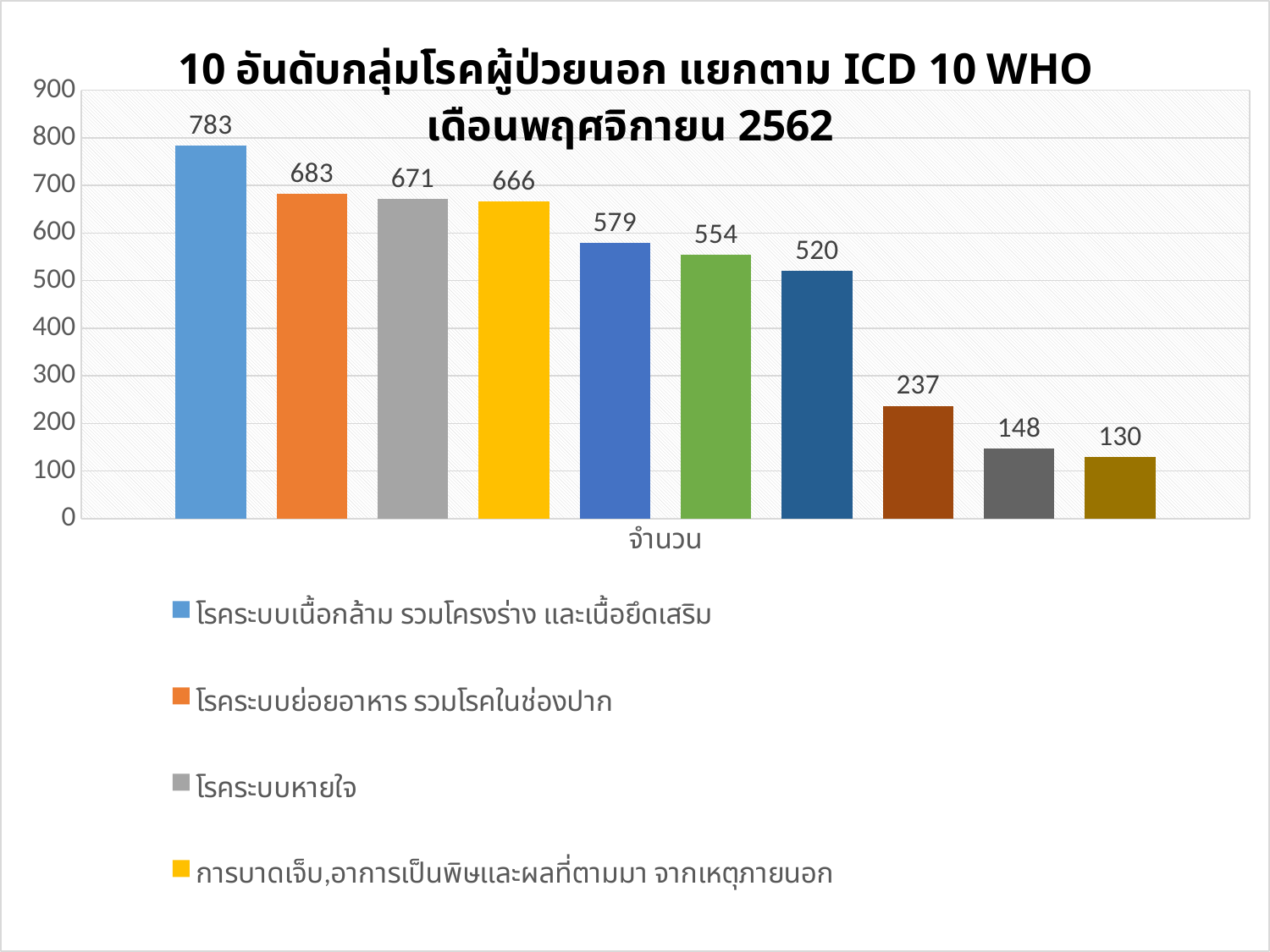
What is the label shown under the x axis of the chart? จำนวน What is the lowest value shown on the chart? 130 How many bars are plotted on the chart? 10 What is the difference between the values for โรคระบบหายใจ and การบาดเจ็บ,อาการเป็นพิษและผลที่ตามมา จากเหตุภายนอก? 5 What is the value for โรคระบบหายใจ? 671 What is the value for การบาดเจ็บ,อาการเป็นพิษและผลที่ตามมา จากเหตุภายนอก? 666 What kind of chart is shown on the slide? Bar chart What is the difference between the values for โรคระบบเนื้อกล้าม รวมโครงร่าง และเนื้อยึดเสริม and โรคระบบย่อยอาหาร รวมโรคในช่องปาก? 100 Which category has the highest value? โรคระบบเนื้อกล้าม รวมโครงร่าง และเนื้อยึดเสริม Which is larger, the value for โรคระบบหายใจ or the value for การบาดเจ็บ,อาการเป็นพิษและผลที่ตามมา จากเหตุภายนอก? โรคระบบหายใจ What is the value for โรคระบบย่อยอาหาร รวมโรคในช่องปาก? 683 Do the bar values rise or fall from left to right? Fall